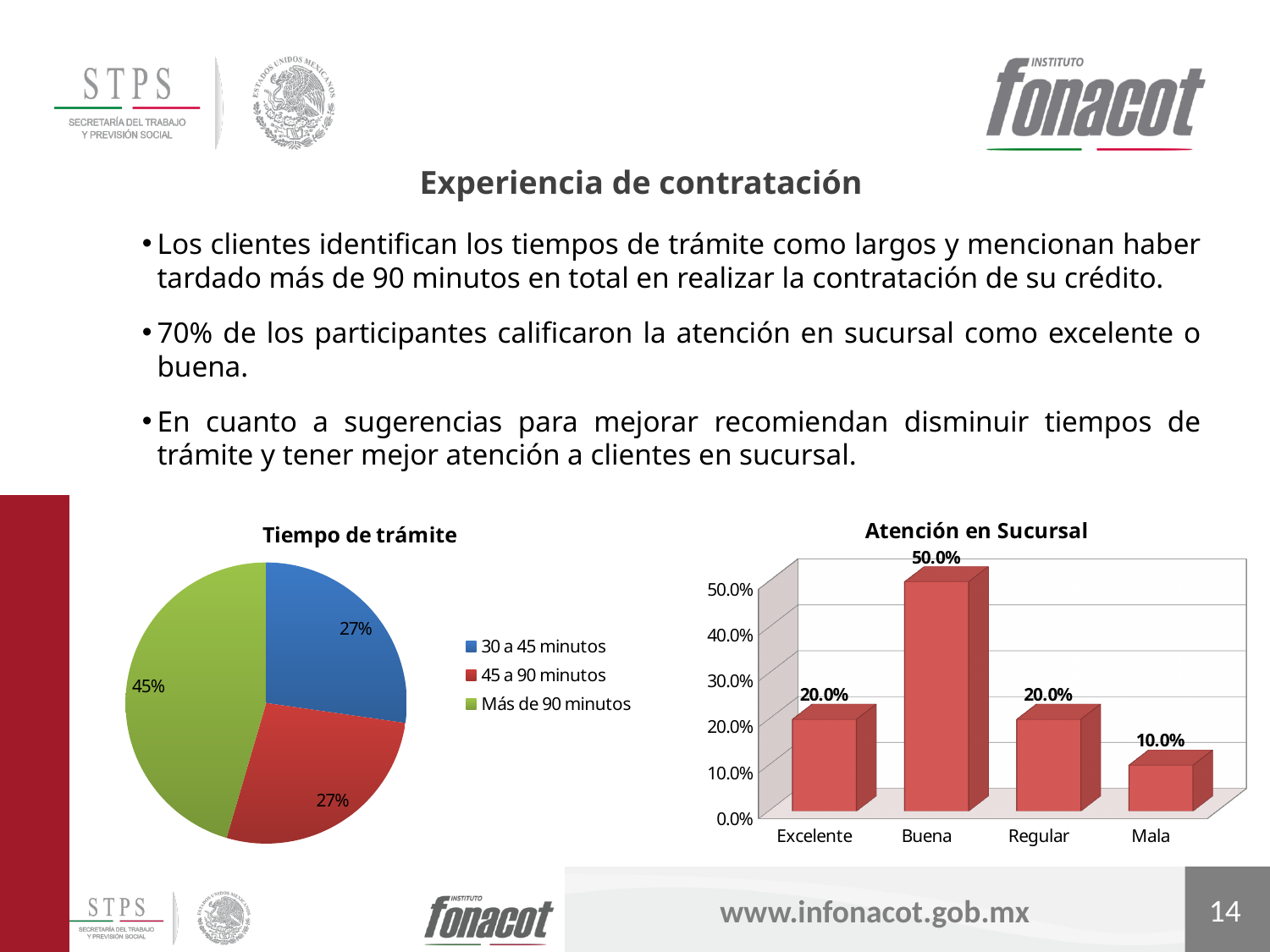
In the 'Atención en Sucursal' chart, what is the value for 'Mala'? 10.0% In the 'Tiempo de trámite' chart, how many categories does the legend list? 3 In the 'Atención en Sucursal' chart, which category has the lowest value? Mala In the 'Atención en Sucursal' chart, what is the value for 'Buena'? 50.0% In the 'Tiempo de trámite' chart, what share of the pie is 'Más de 90 minutos'? 45% In the 'Atención en Sucursal' chart, which category has the highest value? Buena In the 'Tiempo de trámite' chart, what colour is the 'Más de 90 minutos' slice? Green What kind of chart is 'Atención en Sucursal'? Bar chart In the 'Atención en Sucursal' chart, what is the difference between 'Buena' and 'Regular'? 30.0% In the 'Tiempo de trámite' chart, which category has the largest slice? Más de 90 minutos In the 'Tiempo de trámite' chart, what is the value for '30 a 45 minutos'? 27% What kind of chart is 'Tiempo de trámite'? Pie chart